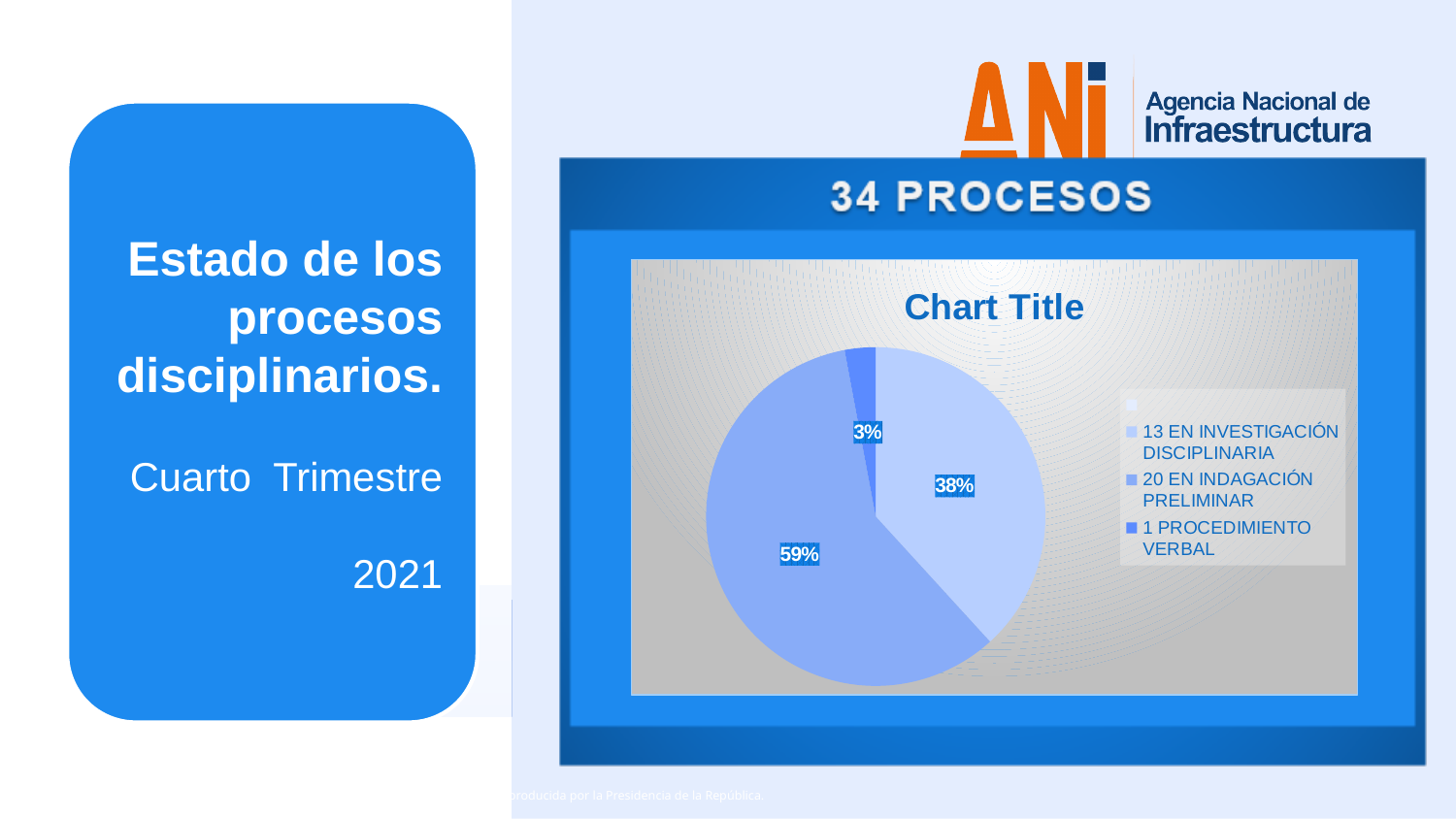
What kind of chart is shown on the slide? pie chart What is the title printed above the pie chart? Chart Title How many slices does the pie chart have? 3 What share of the pie does the slice for 1 PROCEDIMIENTO VERBAL represent? 3% What share of the pie does the slice for 13 EN INVESTIGACIÓN DISCIPLINARIA represent? 38% What is the difference in percentage points between the 38% slice and the 3% slice? 35% Which category has the largest slice of the pie? 20 EN INDAGACIÓN PRELIMINAR Which slice is larger: 13 EN INVESTIGACIÓN DISCIPLINARIA or 1 PROCEDIMIENTO VERBAL? 13 EN INVESTIGACIÓN DISCIPLINARIA Which category has the smallest slice of the pie? 1 PROCEDIMIENTO VERBAL What share of the pie does the slice for 20 EN INDAGACIÓN PRELIMINAR represent? 59% What is the difference in percentage points between the 59% slice and the 38% slice? 21% How many processes in total does the heading above the chart state? 34